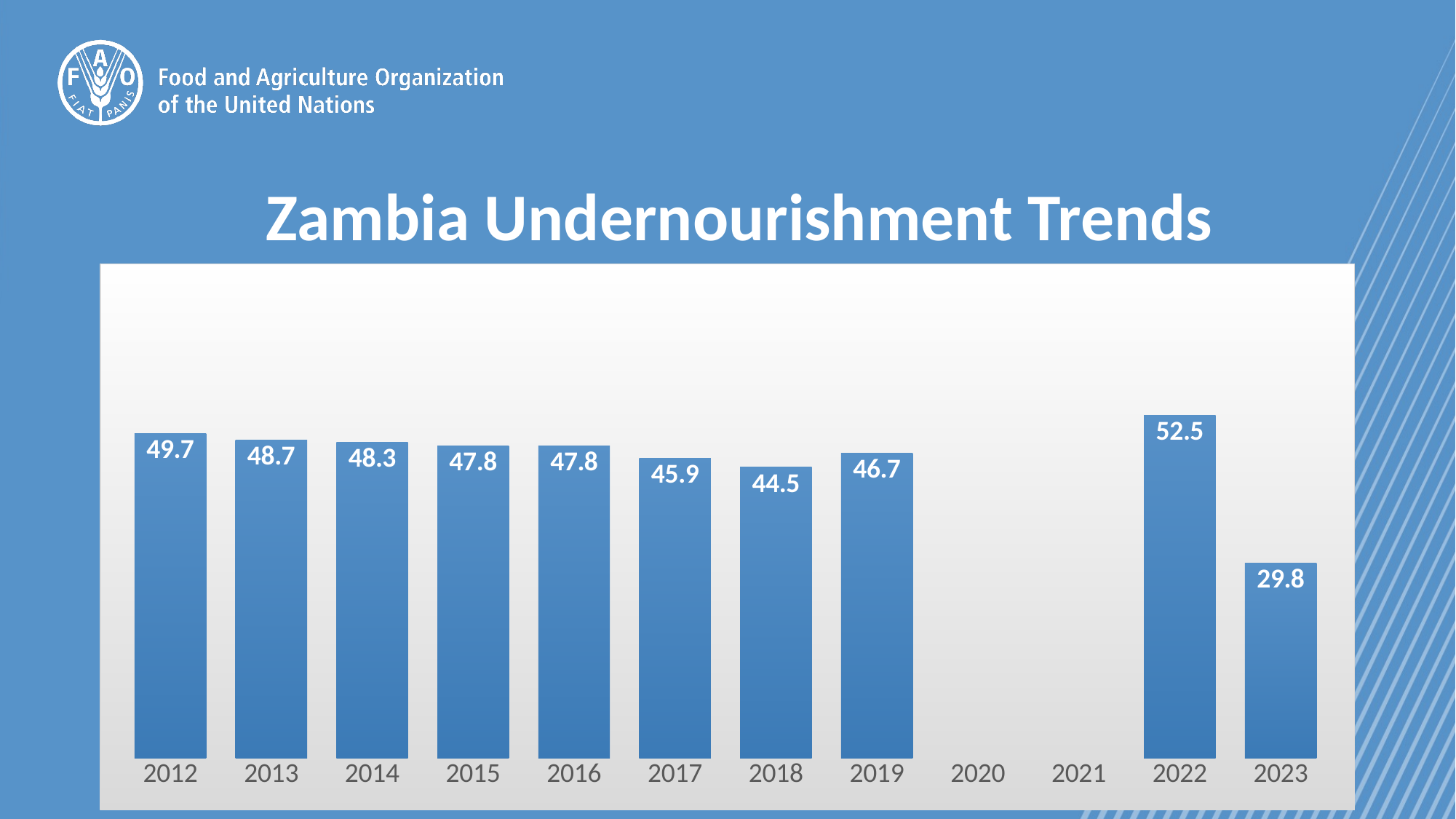
What is the value for 2012? 49.7 Do the values rise or fall from 2012 to 2018? Fall What is the value for 2018? 44.5 What is the value for 2023? 29.8 How many bars are plotted on the chart? 10 What kind of chart is shown on the slide? Bar chart How many years are labelled on the x axis? 12 What is the difference between the values for 2019 and 2018? 2.2 Which year has the highest value? 2022 Which is larger, the value for 2017 or the value for 2019? 2019 Which year has the lowest value among the plotted bars? 2023 What is the difference between the values for 2022 and 2023? 22.7